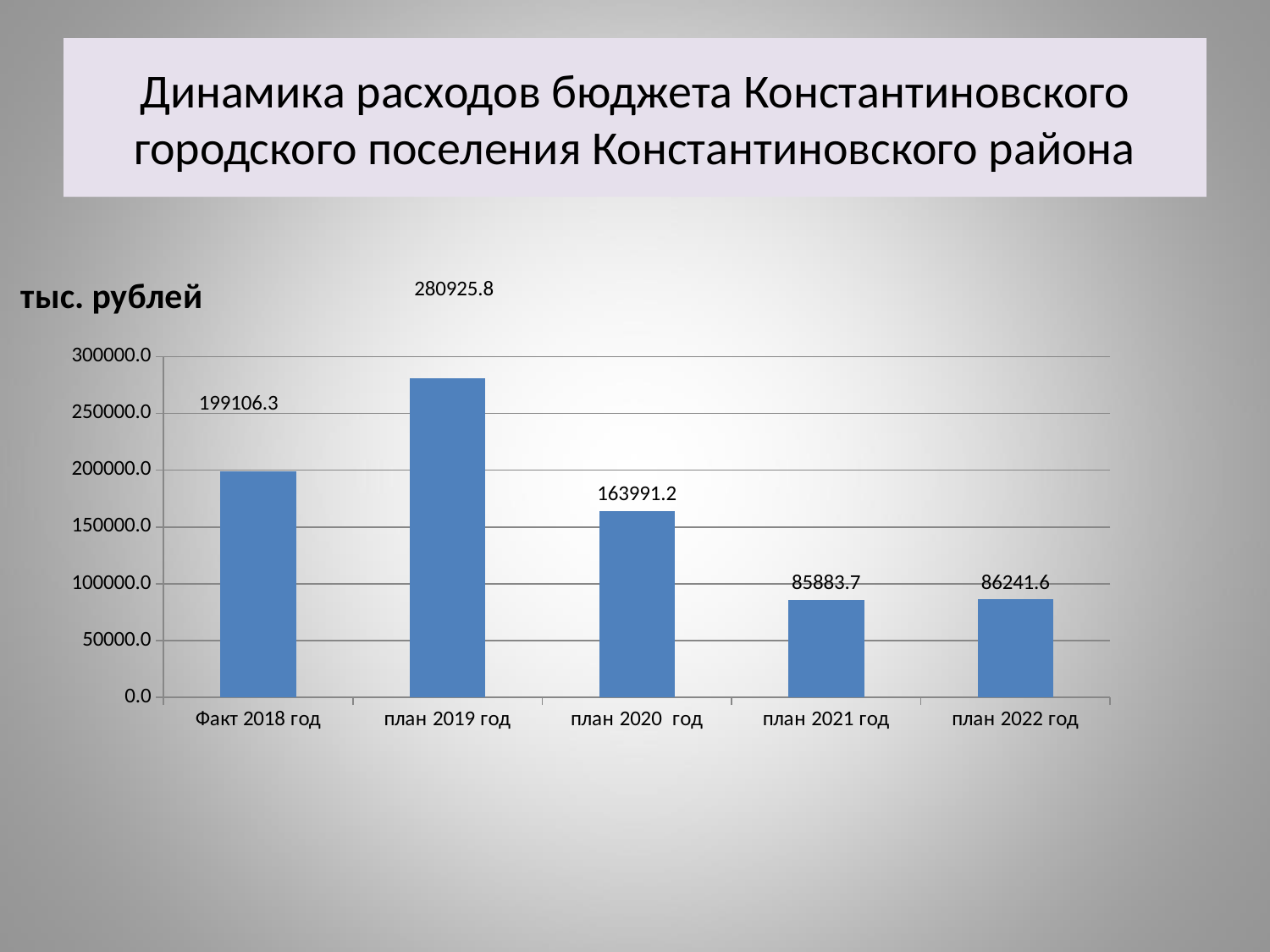
How many categories are shown on the x axis? 5 Which category has the highest value? план 2019 год Is the value for план 2020 год greater or less than 150000.0? greater What is the value for план 2021 год? 85883.7 What kind of chart is shown on the slide? bar chart What is the value for Факт 2018 год? 199106.3 What is the difference between the values for план 2019 год and Факт 2018 год? 81819.5 Which category has the lowest value? план 2021 год Do the values rise or fall from план 2019 год to план 2021 год? fall What is the value for план 2019 год? 280925.8 What is the difference between the values for Факт 2018 год and план 2020 год? 35115.1 Which is larger, the value for план 2020 год or the value for план 2021 год? план 2020 год